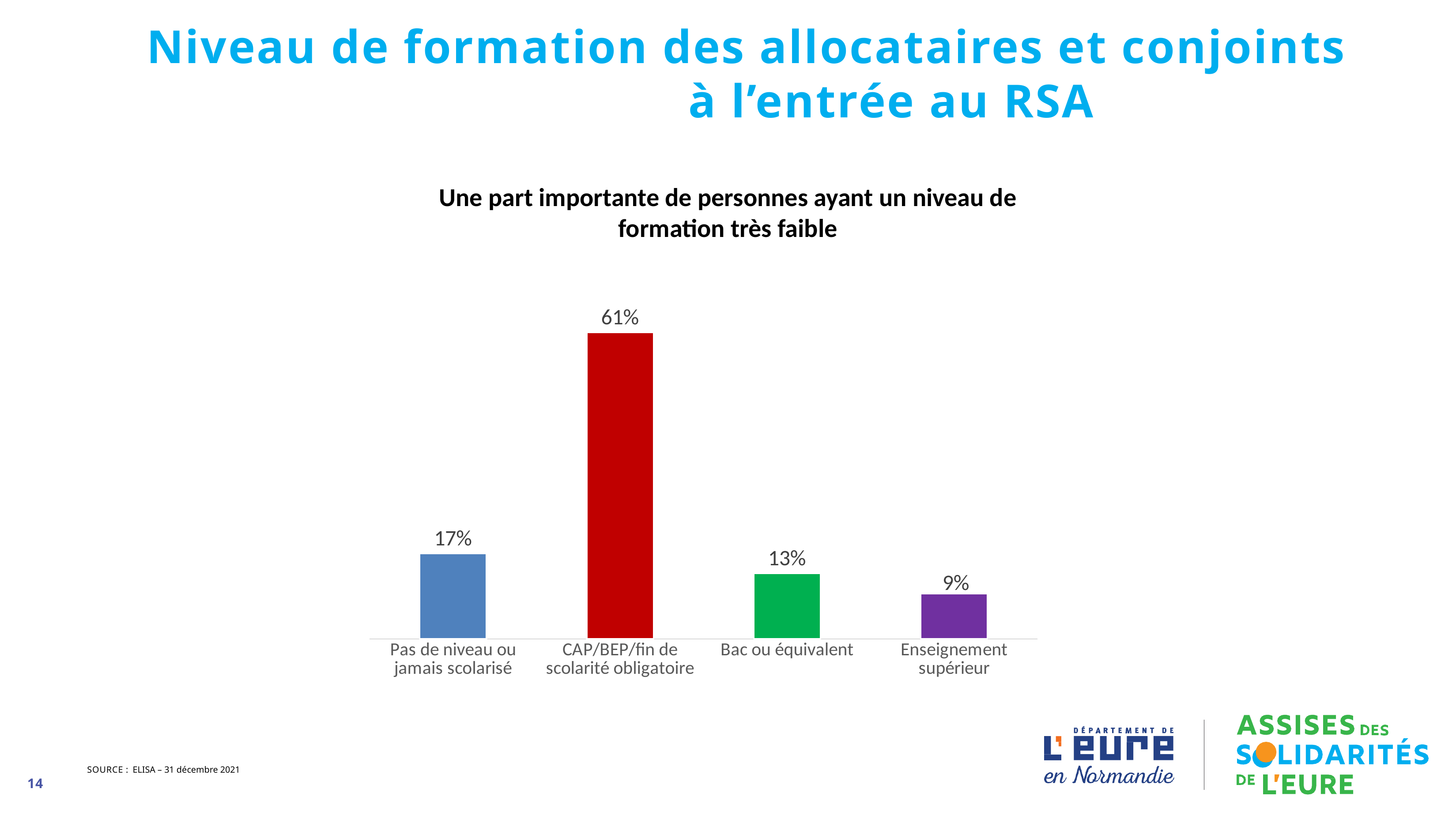
How many categories are shown in the chart? 4 What is the value for Pas de niveau ou jamais scolarisé? 17% Which category has the highest value? CAP/BEP/fin de scolarité obligatoire What is the value for Bac ou équivalent? 13% What is the value for CAP/BEP/fin de scolarité obligatoire? 61% What is the difference between the values for Bac ou équivalent and Enseignement supérieur? 4% What is the difference between the values for CAP/BEP/fin de scolarité obligatoire and Pas de niveau ou jamais scolarisé? 44% What is the value for Enseignement supérieur? 9% What is the title of the chart? Une part importante de personnes ayant un niveau de formation très faible Which is larger, the value for Pas de niveau ou jamais scolarisé or the value for Bac ou équivalent? Pas de niveau ou jamais scolarisé What kind of chart is shown on the slide? Bar chart Which category has the lowest value? Enseignement supérieur